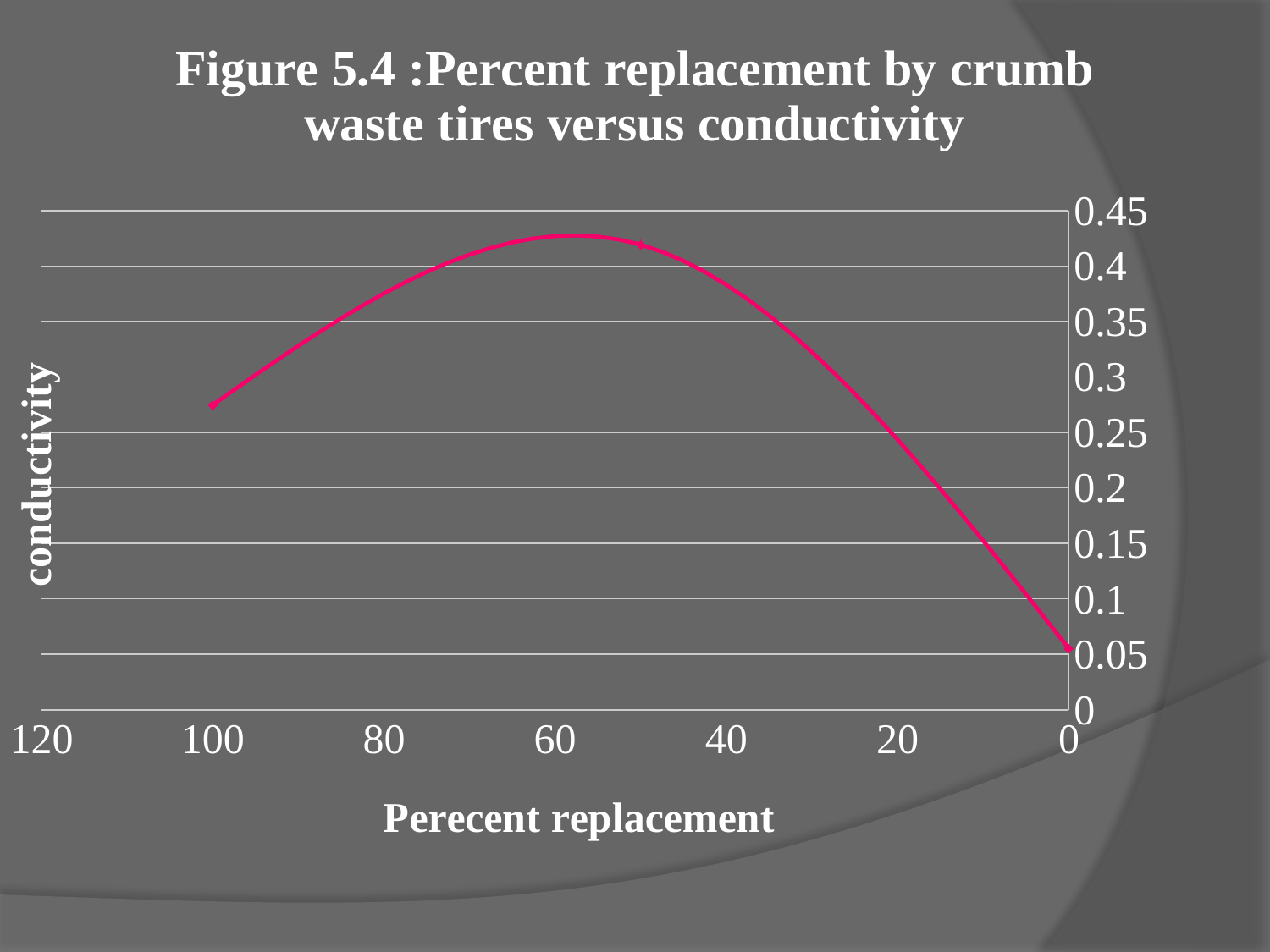
Which has the higher conductivity: 50 percent replacement or 100 percent replacement? 50 percent replacement At which percent replacement is the conductivity highest? 50 Does the conductivity rise or fall as percent replacement goes from 50 down to 0? falls What is the label of the vertical axis? conductivity Is the conductivity at 50 percent replacement greater or less than 0.4? greater What kind of chart is shown on the slide? line chart At which percent replacement is the conductivity lowest? 0 Is the conductivity at 0 percent replacement greater or less than 0.1? less Which has the higher conductivity: 100 percent replacement or 0 percent replacement? 100 percent replacement How many data points are plotted on the line? 3 What is the title of the chart? Figure 5.4 :Percent replacement by crumb waste tires versus conductivity Is the conductivity at 100 percent replacement greater or less than 0.25? greater